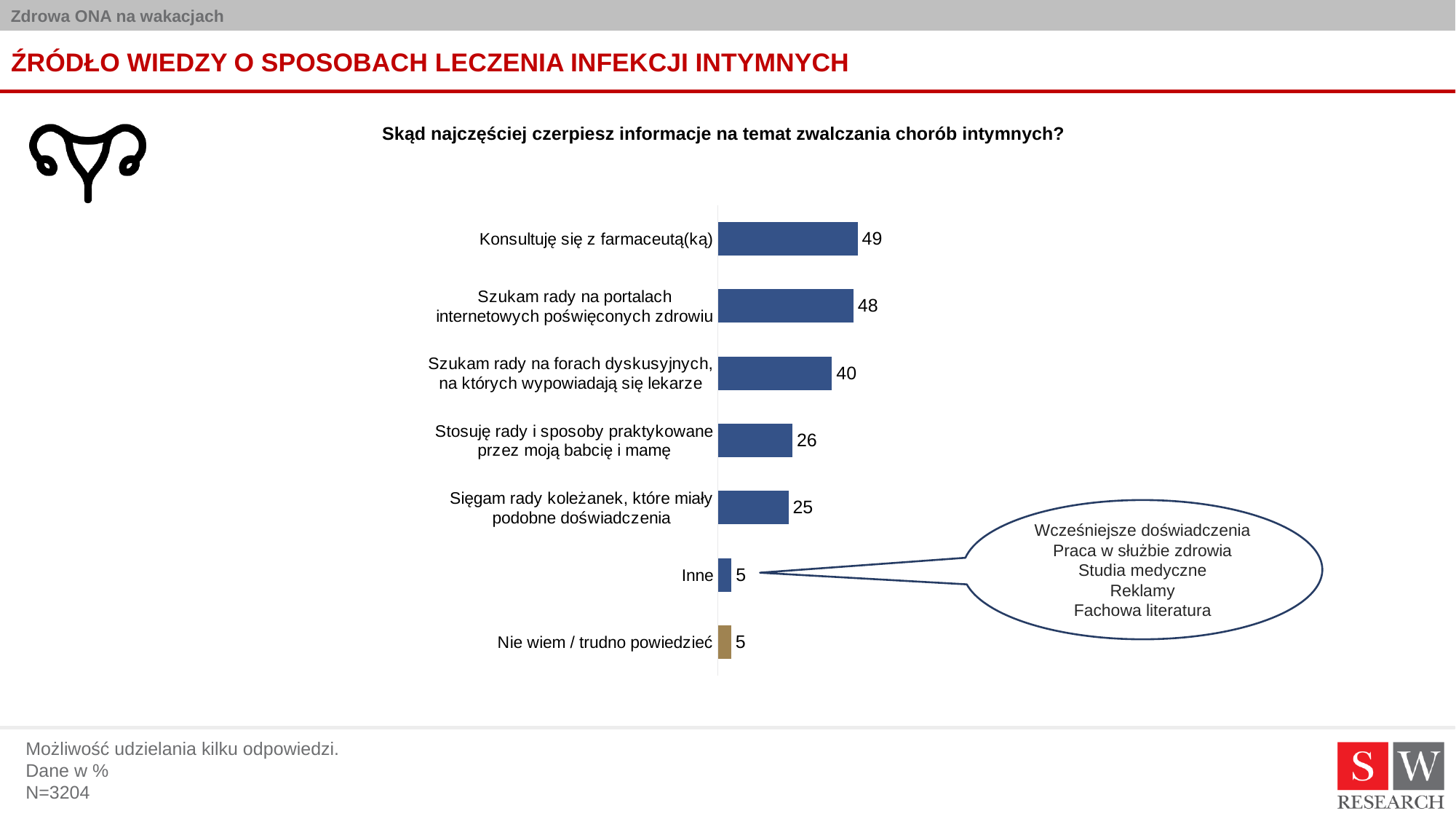
What value is shown for "Konsultuję się z farmaceutą(ką)"? 49 What value is shown for "Inne"? 5 Which is larger: the value for "Szukam rady na forach dyskusyjnych, na których wypowiadają się lekarze" or for "Stosuję rady i sposoby praktykowane przez moją babcię i mamę"? Szukam rady na forach dyskusyjnych, na których wypowiadają się lekarze Which category has the highest value? Konsultuję się z farmaceutą(ką) What kind of chart is shown on the slide? Bar chart What is the difference between the values for "Szukam rady na portalach internetowych poświęconych zdrowiu" and "Stosuję rady i sposoby praktykowane przez moją babcię i mamę"? 22 What value is shown for "Sięgam rady koleżanek, które miały podobne doświadczenia"? 25 What value is shown for "Szukam rady na forach dyskusyjnych, na których wypowiadają się lekarze"? 40 How many categories are shown in the chart? 7 What question is the chart answering, as shown in its title? Skąd najczęściej czerpiesz informacje na temat zwalczania chorób intymnych? What is the difference between the values for "Konsultuję się z farmaceutą(ką)" and "Szukam rady na portalach internetowych poświęconych zdrowiu"? 1 Which category's bar is shown in a different colour (brown) from the others? Nie wiem / trudno powiedzieć